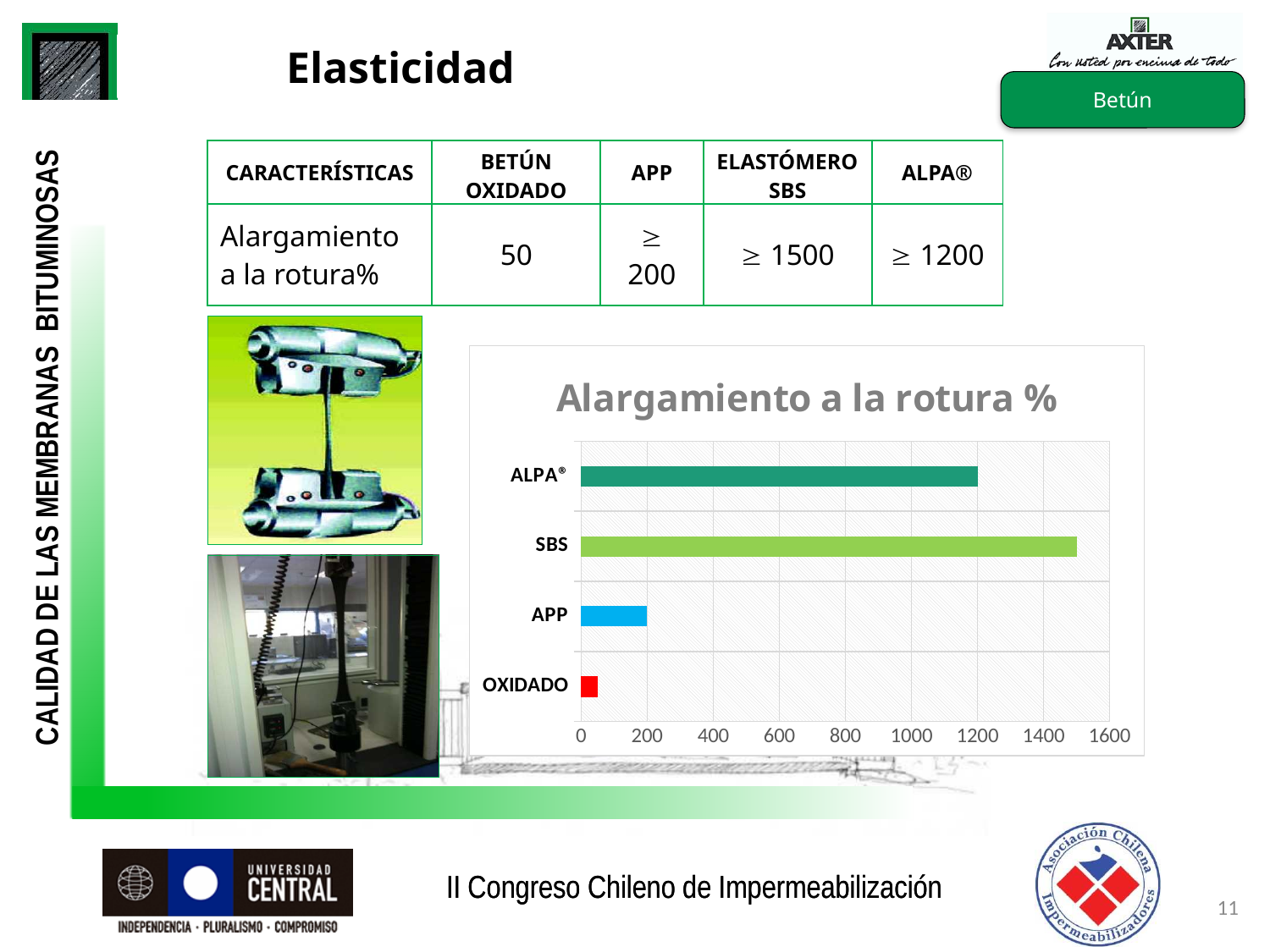
Which is larger, the value for SBS or the value for ALPA®? SBS How many categories are plotted in the chart? 4 Is the value for SBS greater or less than 1400? greater Which category has the highest value in the chart? SBS What is the title of the chart? Alargamiento a la rotura % What type of chart is shown on the slide? bar chart Which category has the lowest value in the chart? OXIDADO What is the difference between the values for ALPA® and APP? 1000 Is the value for OXIDADO greater or less than 200? less What is the value for APP in the chart? 200 What is the value for ALPA® in the chart? 1200 What colour is the bar for OXIDADO? red